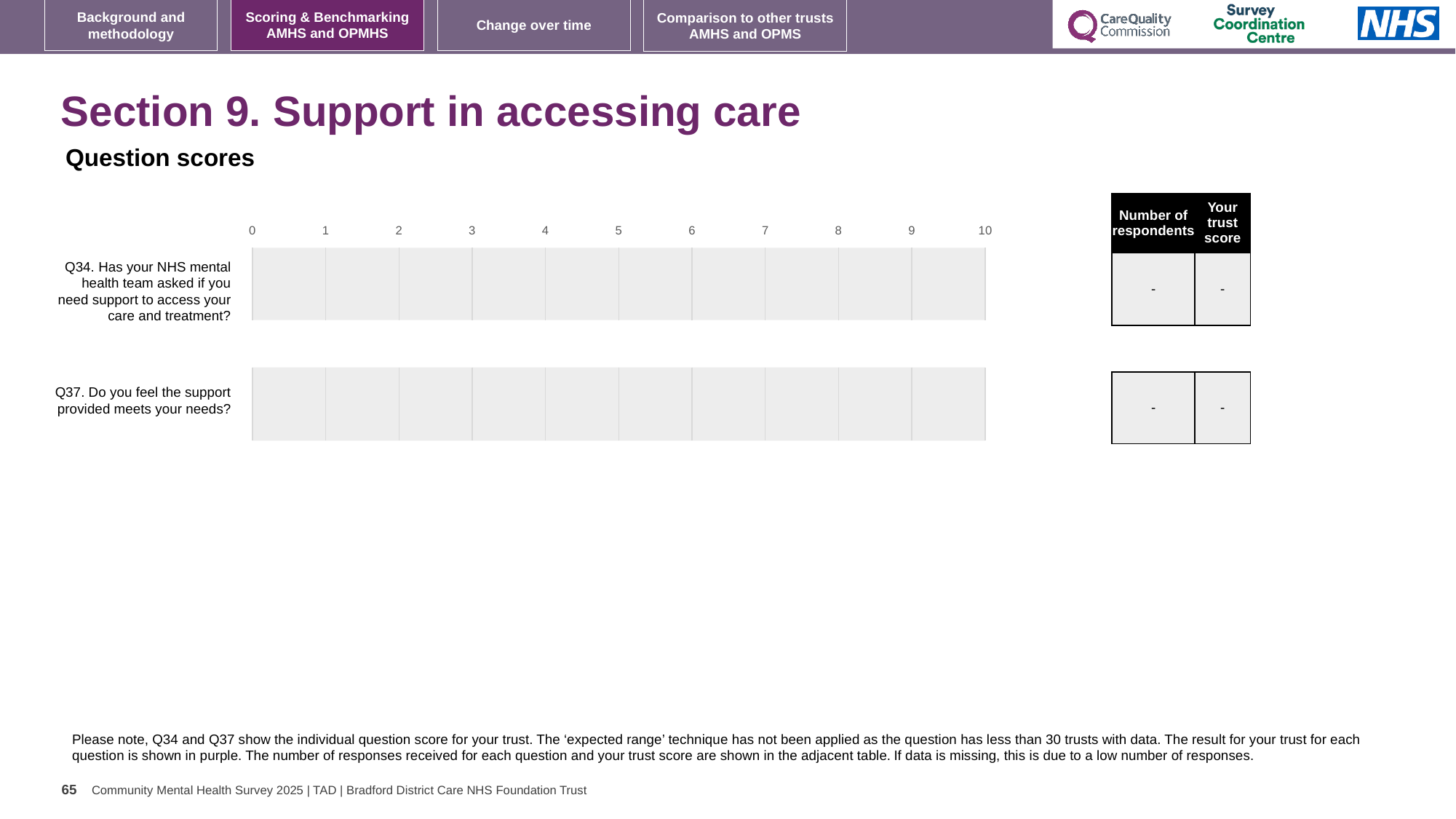
What value is shown in the 'Your trust score' column for Q34? - What kind of chart is shown on the slide? bar chart What is the highest value shown on the chart's axis? 10 What value is shown in the 'Number of respondents' column for Q37? - How many questions (categories) are listed on the chart? 2 What is the heading shown above the chart? Question scores